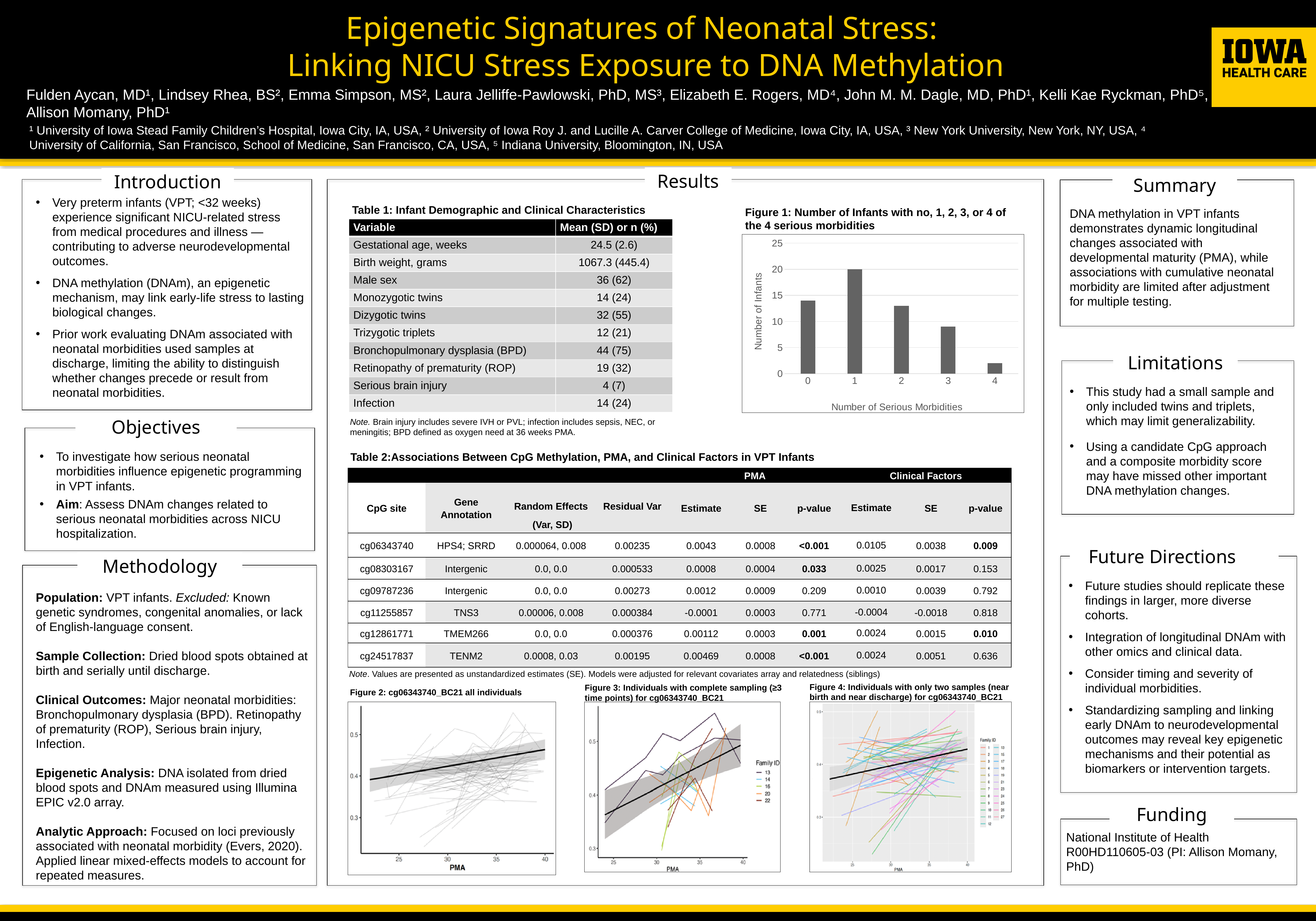
In Figure 1, which has more infants: 0 serious morbidities or 3 serious morbidities? 0 In Figure 1, is the number of infants with 0 serious morbidities greater or less than 10? greater What is the y-axis label of Figure 1? Number of Infants In Figure 1, is the number of infants with 2 serious morbidities greater or less than 15? less In Figure 1, is the number of infants with 3 serious morbidities greater or less than 10? less In Figure 1, how many bars (categories) are plotted? 5 In Figure 1, which number of serious morbidities has the highest number of infants? 1 What is the x-axis label of Figure 1? Number of Serious Morbidities In Figure 1, do the bars rise or fall from 1 to 4 serious morbidities? fall In Figure 1, which number of serious morbidities has the lowest number of infants? 4 What kind of chart is Figure 1? bar chart